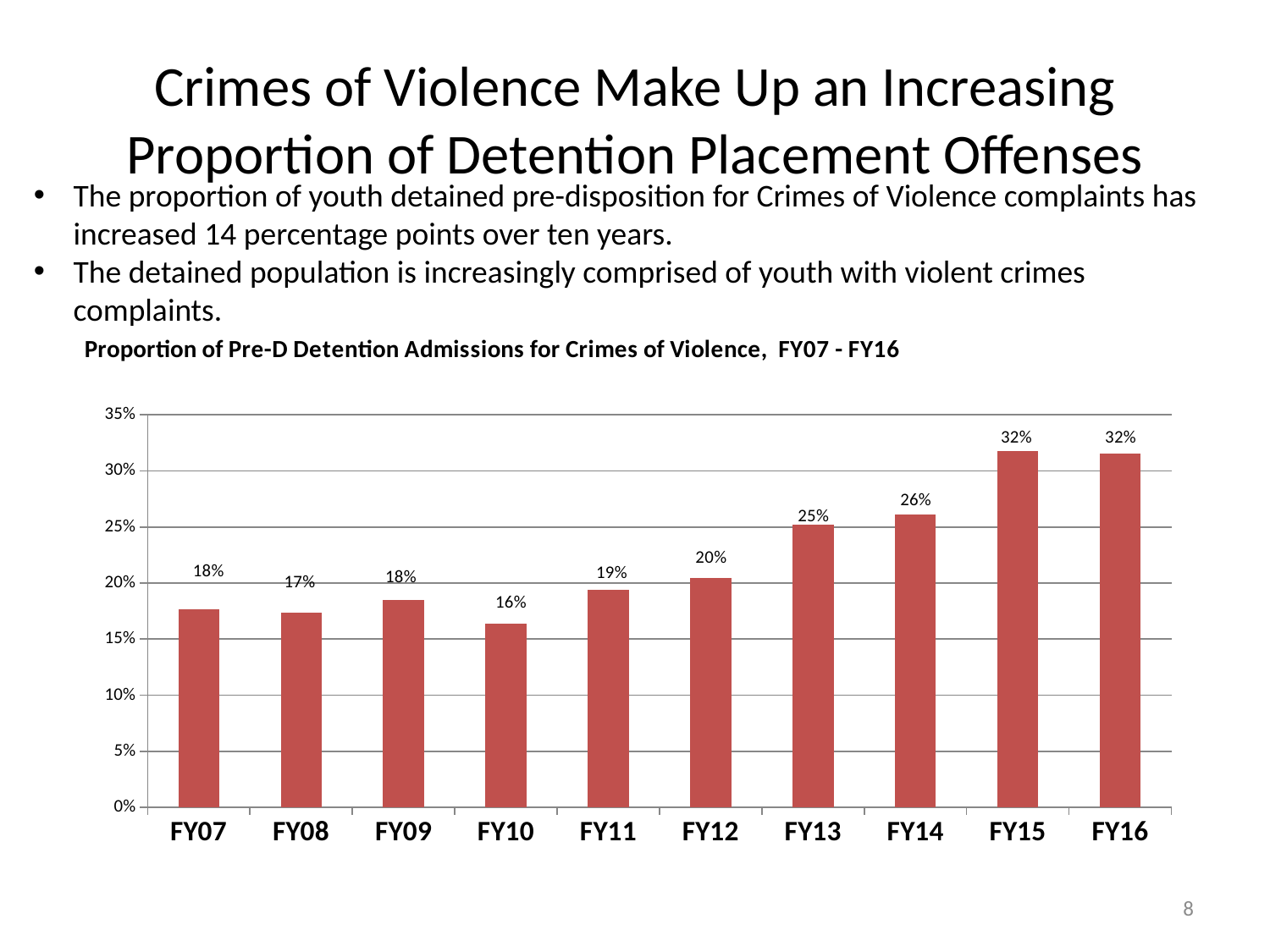
What kind of chart is shown on the slide? Bar chart What is the title of the chart? Proportion of Pre-D Detention Admissions for Crimes of Violence, FY07 - FY16 Which fiscal year has the lowest proportion? FY10 Is the value for FY15 greater or less than 30%? greater Which is larger, the value for FY11 or the value for FY13? FY13 What is the difference in percentage points between FY16 and FY10? 16 What is the value for FY13? 25% What is the value for FY10? 16% What is the value for FY07? 18% Do the values generally rise or fall from FY10 to FY16? Rise How many fiscal years are shown on the x axis? 10 What is the difference in percentage points between FY14 and FY12? 6